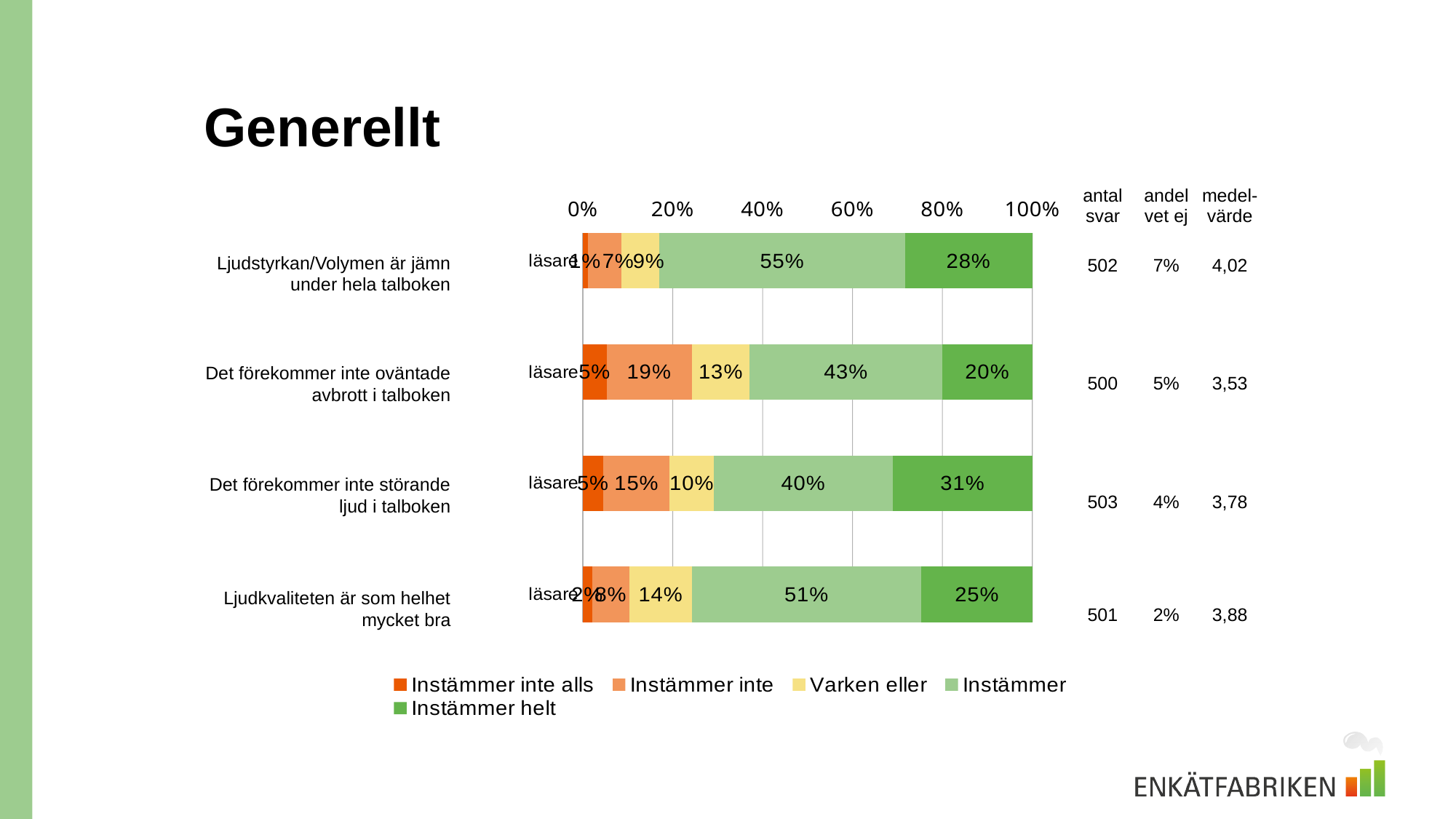
Which is larger: the 'Instämmer inte' value for 'Det förekommer inte oväntade avbrott i talboken' or for 'Ljudkvaliteten är som helhet mycket bra'? Det förekommer inte oväntade avbrott i talboken Which statement has the highest 'Instämmer helt' share? Det förekommer inte störande ljud i talboken What is the title of the slide containing the chart? Generellt What kind of chart is shown on the slide? Stacked bar chart What is the 'Instämmer inte' value for 'Det förekommer inte oväntade avbrott i talboken'? 19% How many series does the legend list? 5 How many statements (categories) are plotted in the chart? 4 What is the 'Instämmer' value for 'Ljudstyrkan/Volymen är jämn under hela talboken'? 55% What is the 'Varken eller' value for 'Ljudkvaliteten är som helhet mycket bra'? 14% Which statement has the lowest 'Instämmer' share? Det förekommer inte störande ljud i talboken What is the difference between the 'Instämmer' values for 'Ljudstyrkan/Volymen är jämn under hela talboken' and 'Det förekommer inte oväntade avbrott i talboken'? 12% What is the 'Instämmer helt' value for 'Det förekommer inte störande ljud i talboken'? 31%